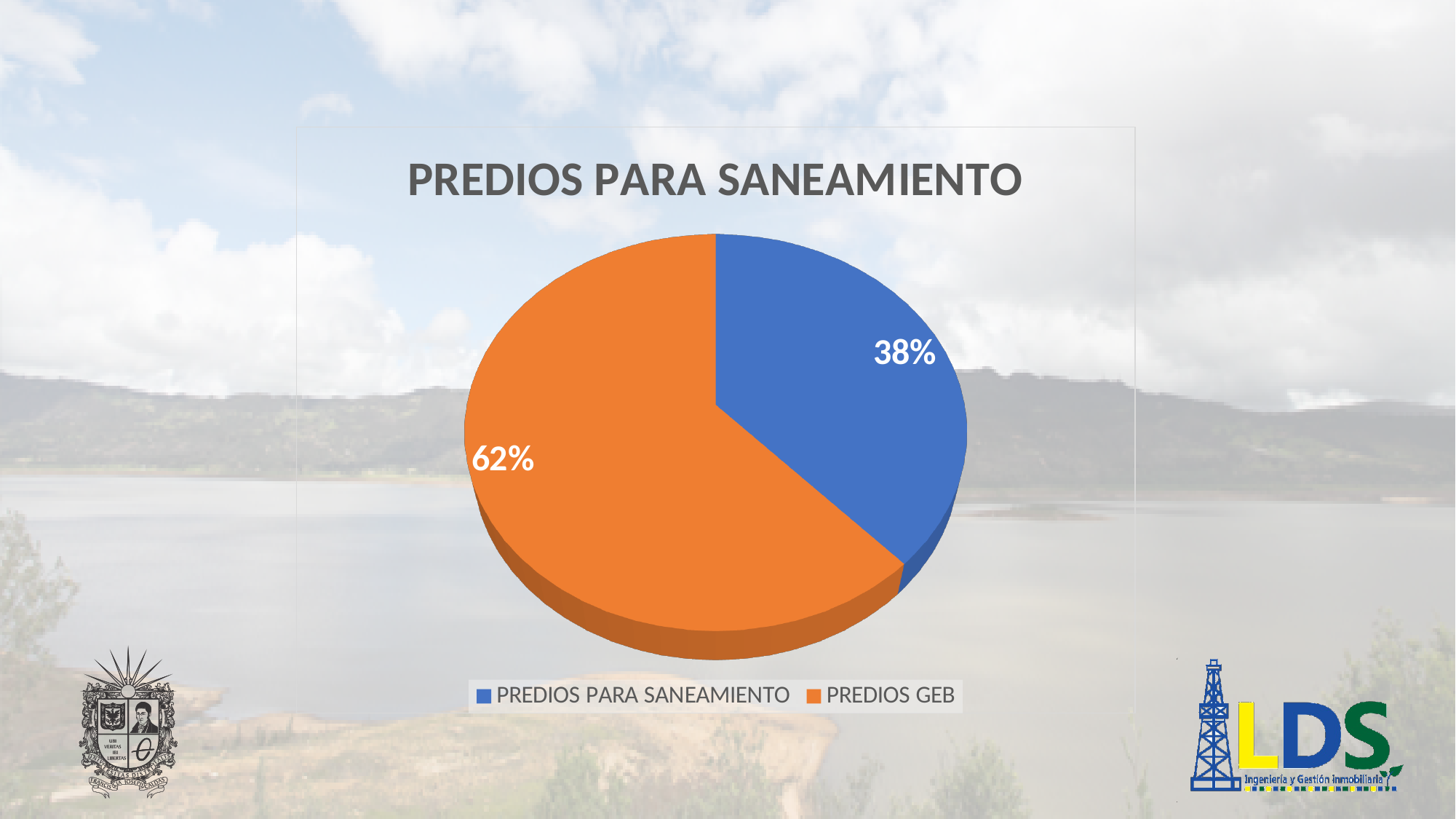
What kind of chart is shown on the slide? pie chart What share of the pie does PREDIOS PARA SANEAMIENTO represent? 38% What share of the pie does PREDIOS GEB represent? 62% Which slice is the smallest? PREDIOS PARA SANEAMIENTO How many entries does the legend list? 2 What is the difference in percentage points between PREDIOS GEB and PREDIOS PARA SANEAMIENTO? 24 What is the title of the chart? PREDIOS PARA SANEAMIENTO Which is larger, PREDIOS GEB or PREDIOS PARA SANEAMIENTO? PREDIOS GEB How many slices does the pie chart have? 2 What colour is the PREDIOS GEB slice? orange Which slice is the largest? PREDIOS GEB